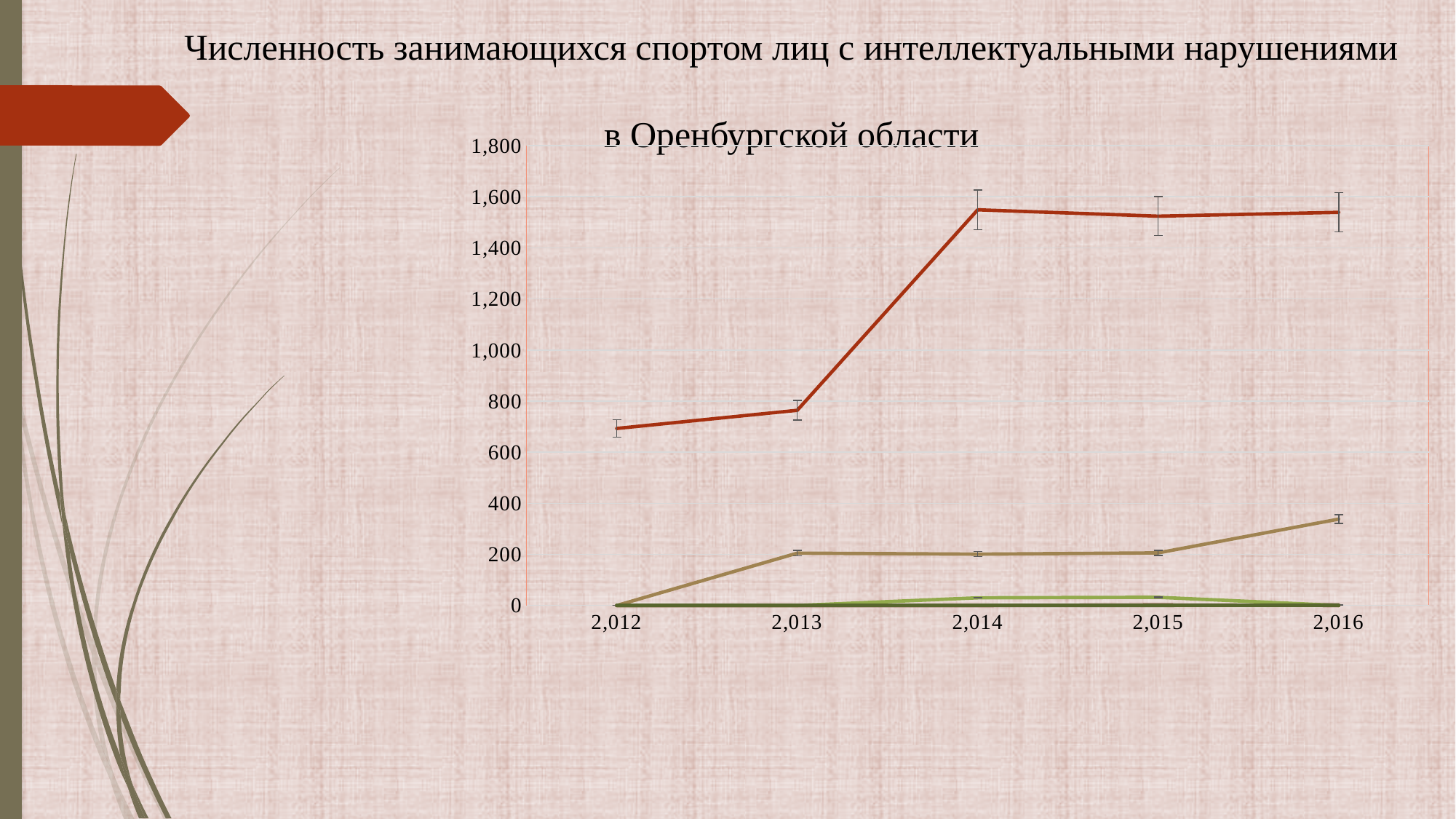
Is the value of the red line for 2,014 greater or less than 1,400? greater What kind of chart is shown on the slide? line chart Is the value of the red line for 2,012 greater or less than 800? less What is the title of the chart on the slide? Численность занимающихся спортом лиц с интеллектуальными нарушениями в Оренбургской области Is the value of the tan line for 2,013 greater or less than 400? less How many years are shown along the x axis of the chart? 5 For 2,014, which line has the larger value, the red line or the tan line? the red line In which year is the red line at its lowest value? 2,012 Does the red line rise or fall between 2,013 and 2,014? rise In which year is the tan line at its highest value? 2,016